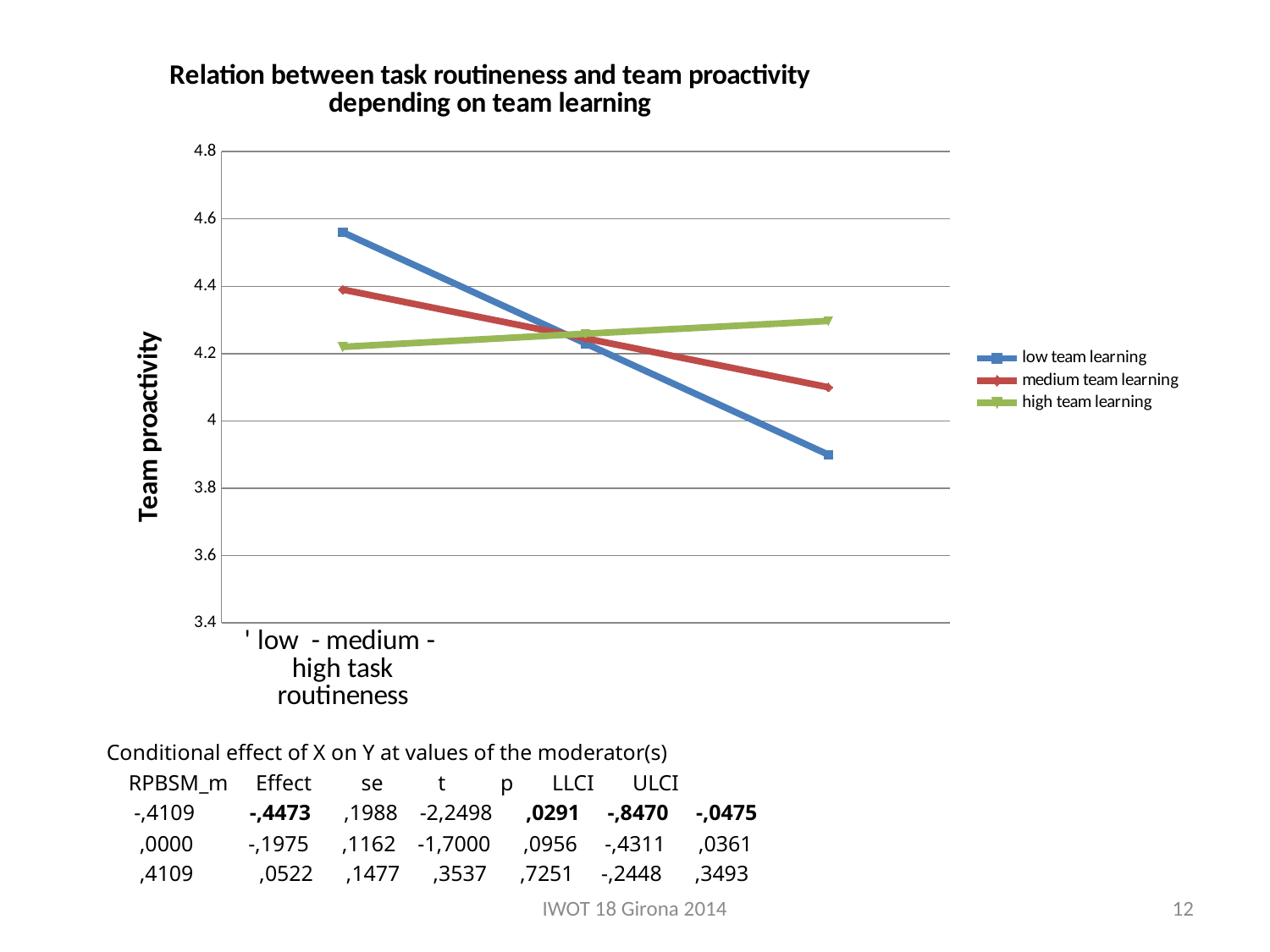
How many series does the legend list? 3 Which series has the highest team proactivity at low task routineness? low team learning At high task routineness, which is larger: medium team learning or high team learning? high team learning What is the label of the vertical axis? Team proactivity What kind of chart is shown on the slide? line chart Does the medium team learning line rise or fall as task routineness increases? fall What is the title of the chart? Relation between task routineness and team proactivity depending on team learning Which series has the lowest team proactivity at high task routineness? low team learning Is the value for low team learning at high task routineness greater or less than 4? less Does the low team learning line rise or fall as task routineness increases? fall Does the high team learning line rise or fall as task routineness increases? rise Is the value for low team learning at low task routineness greater or less than 4.4? greater